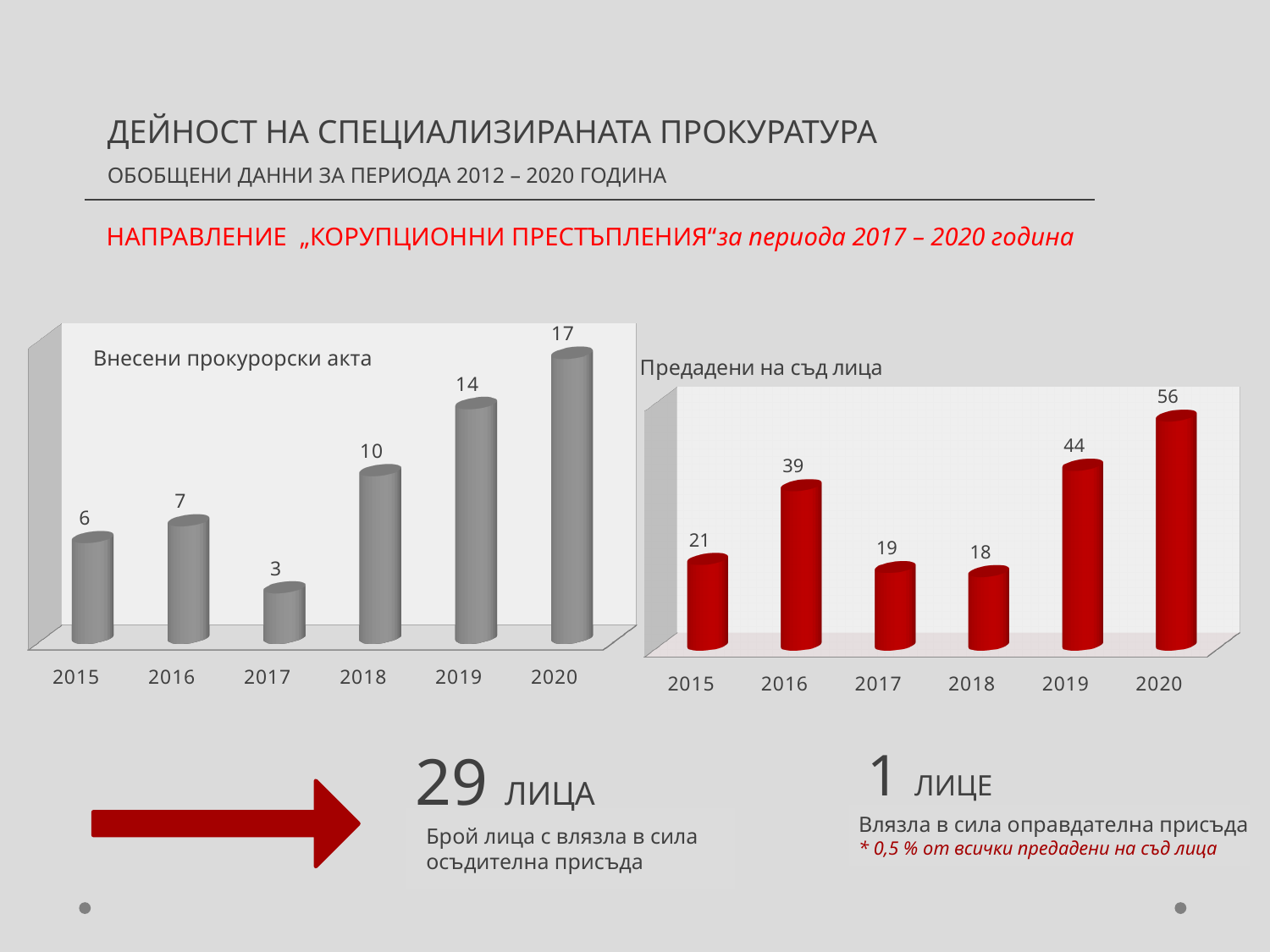
In the chart titled "Предадени на съд лица", what is the difference between the values for 2020 and 2019? 12 In the chart titled "Внесени прокурорски акта", which year has the highest value? 2020 In the chart titled "Предадени на съд лица", which is larger, the value for 2015 or the value for 2017? 2015 In the chart titled "Внесени прокурорски акта", which year has the lowest value? 2017 In the chart titled "Внесени прокурорски акта", what is the difference between the values for 2019 and 2016? 7 In the chart titled "Внесени прокурорски акта", do the values rise or fall from 2017 to 2020? rise What kind of chart is the chart titled "Внесени прокурорски акта"? bar chart In the chart titled "Внесени прокурорски акта", what is the value for 2018? 10 In the chart titled "Предадени на съд лица", which year has the lowest value? 2018 What colour are the bars in the chart titled "Предадени на съд лица"? red In the chart titled "Предадени на съд лица", what is the value for 2016? 39 How many years are shown on the x axis of the chart titled "Предадени на съд лица"? 6